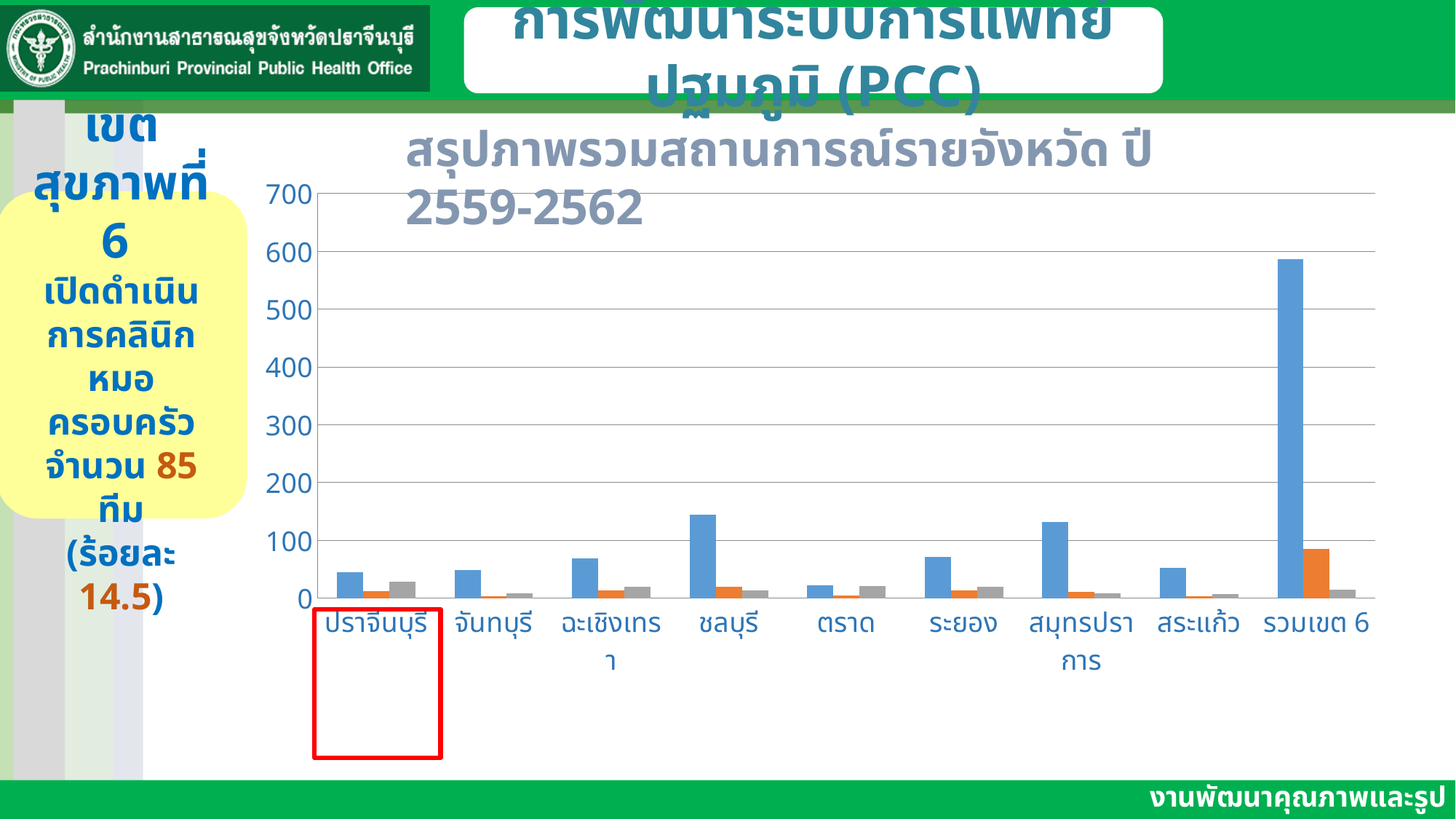
Among the individual provinces (excluding รวมเขต 6), which has the tallest blue bar? ชลบุรี Which category has the tallest blue bar in the chart? รวมเขต 6 Is the orange bar for รวมเขต 6 greater or less than 100? less Which has the taller blue bar, ชลบุรี or ระยอง? ชลบุรี Is the blue bar for รวมเขต 6 greater or less than 500? greater What kind of chart is shown on the slide? bar chart Is the blue bar for ปราจีนบุรี greater or less than 100? less How many bars are plotted for each category in the chart? 3 How many categories are shown on the x axis of the chart? 9 Which category has the shortest blue bar in the chart? ตราด What is the title of the chart? สรุปภาพรวมสถานการณ์รายจังหวัด ปี 2559-2562